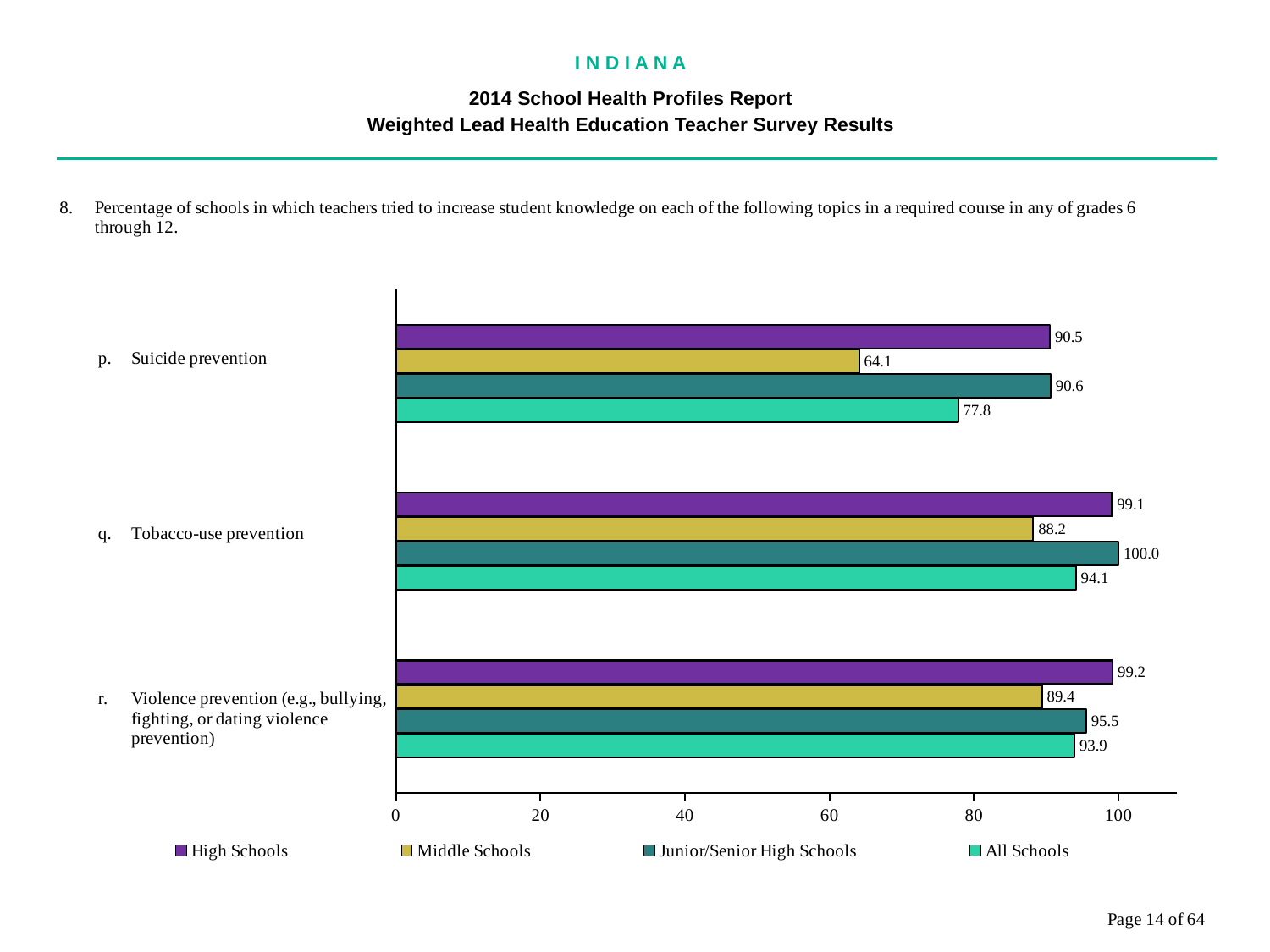
Is the value for All Schools for Suicide prevention greater or less than 80? less What is the value for High Schools for Violence prevention? 99.2 How many series does the legend list? 4 What kind of chart is shown on the slide? bar chart What is the value for All Schools for Violence prevention (e.g., bullying, fighting, or dating violence prevention)? 93.9 Which is larger for Violence prevention: the Middle Schools value or the Junior/Senior High Schools value? Junior/Senior High Schools What is the value for Junior/Senior High Schools for Tobacco-use prevention? 100.0 Which school type has the highest value for Tobacco-use prevention? Junior/Senior High Schools What is the difference between the High Schools and Middle Schools values for Suicide prevention? 26.4 Which school type has the lowest value for Suicide prevention? Middle Schools What is the value for Middle Schools for Suicide prevention? 64.1 How many topics (categories) are shown on the chart? 3